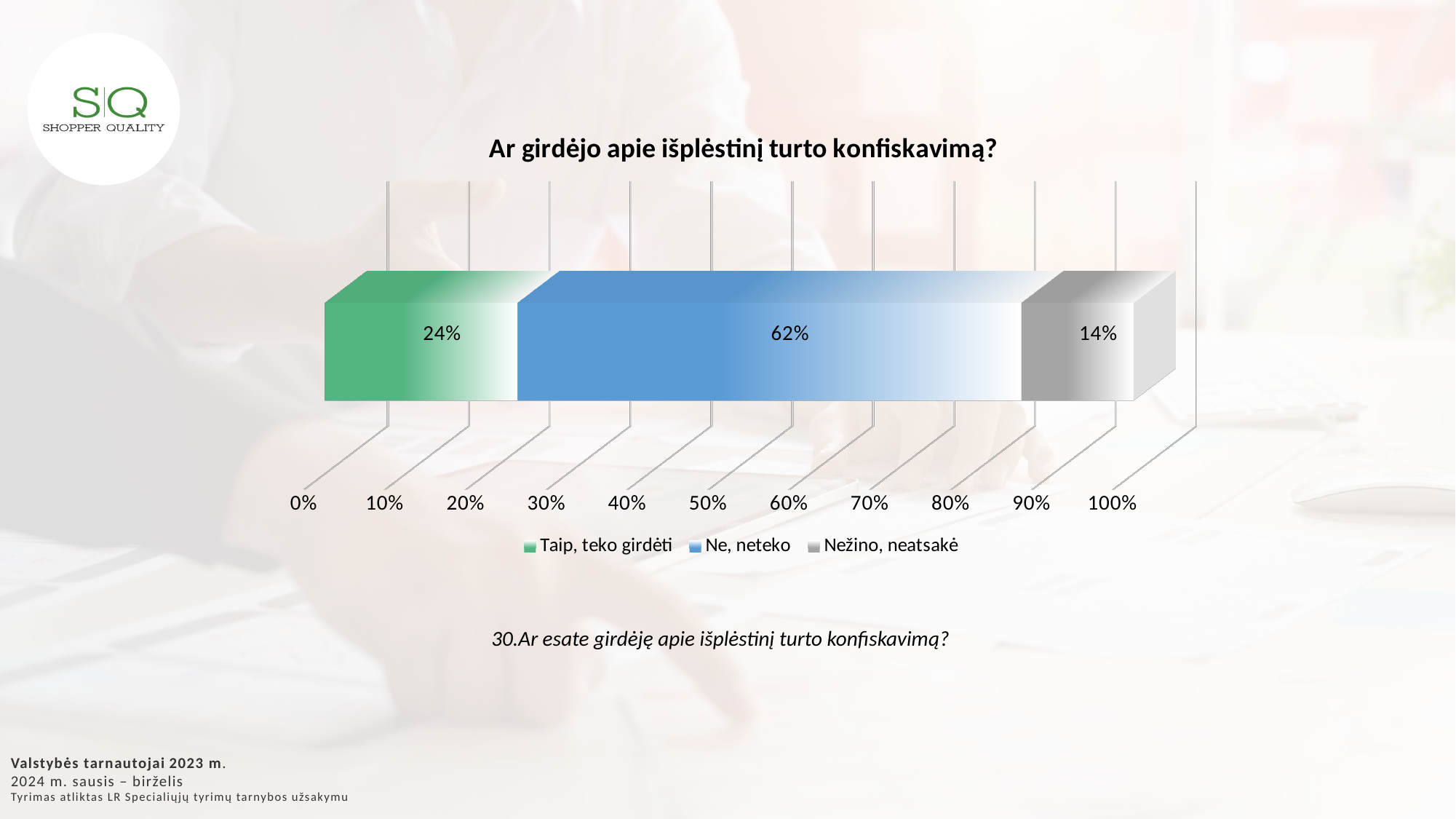
What percentage of respondents answered "Nežino, neatsakė"? 14% How many series does the legend list? 3 Is the value for "Ne, neteko" greater or less than 50%? greater Which response has the smallest share? Nežino, neatsakė Which response has the largest share? Ne, neteko What is the difference in percentage points between "Ne, neteko" and "Taip, teko girdėti"? 38 What is the title of the chart? Ar girdėjo apie išplėstinį turto konfiskavimą? What is the total of the stacked bar? 100% What percentage of respondents answered "Ne, neteko"? 62% Which is larger: the share for "Taip, teko girdėti" or for "Nežino, neatsakė"? Taip, teko girdėti What kind of chart is shown on the slide? Stacked bar chart What percentage of respondents answered "Taip, teko girdėti"? 24%